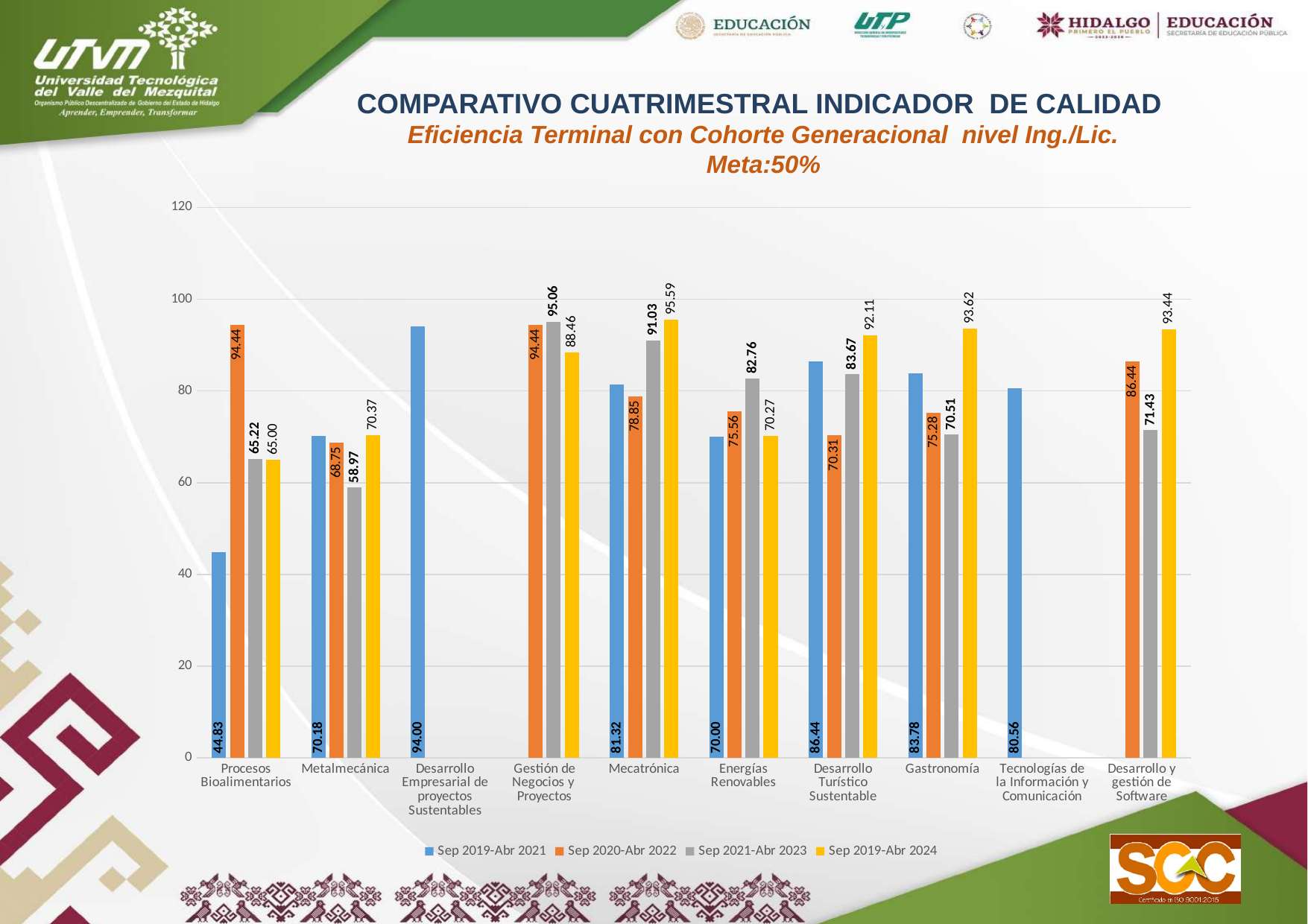
Which category has the highest value in the Sep 2019-Abr 2024 series? Mecatrónica For Metalmecánica, which series has the larger value: Sep 2019-Abr 2021 or Sep 2020-Abr 2022? Sep 2019-Abr 2021 Is the Sep 2019-Abr 2021 value for Desarrollo Empresarial de proyectos Sustentables greater or less than 80? greater Which category has the lowest value in the Sep 2019-Abr 2021 series? Procesos Bioalimentarios For Gastronomía, what is the difference between the Sep 2019-Abr 2024 value and the Sep 2019-Abr 2021 value? 9.84 How many series does the legend list? 4 What is the value for Procesos Bioalimentarios in the Sep 2019-Abr 2021 series? 44.83 What is the value for Gestión de Negocios y Proyectos in the Sep 2021-Abr 2023 series? 95.06 What is the value for Mecatrónica in the Sep 2019-Abr 2024 series? 95.59 How many categories (programs) are shown on the x axis of the chart? 10 For Procesos Bioalimentarios, how much higher is the Sep 2020-Abr 2022 value than the Sep 2019-Abr 2021 value? 49.61 What kind of chart is shown on the slide? bar chart